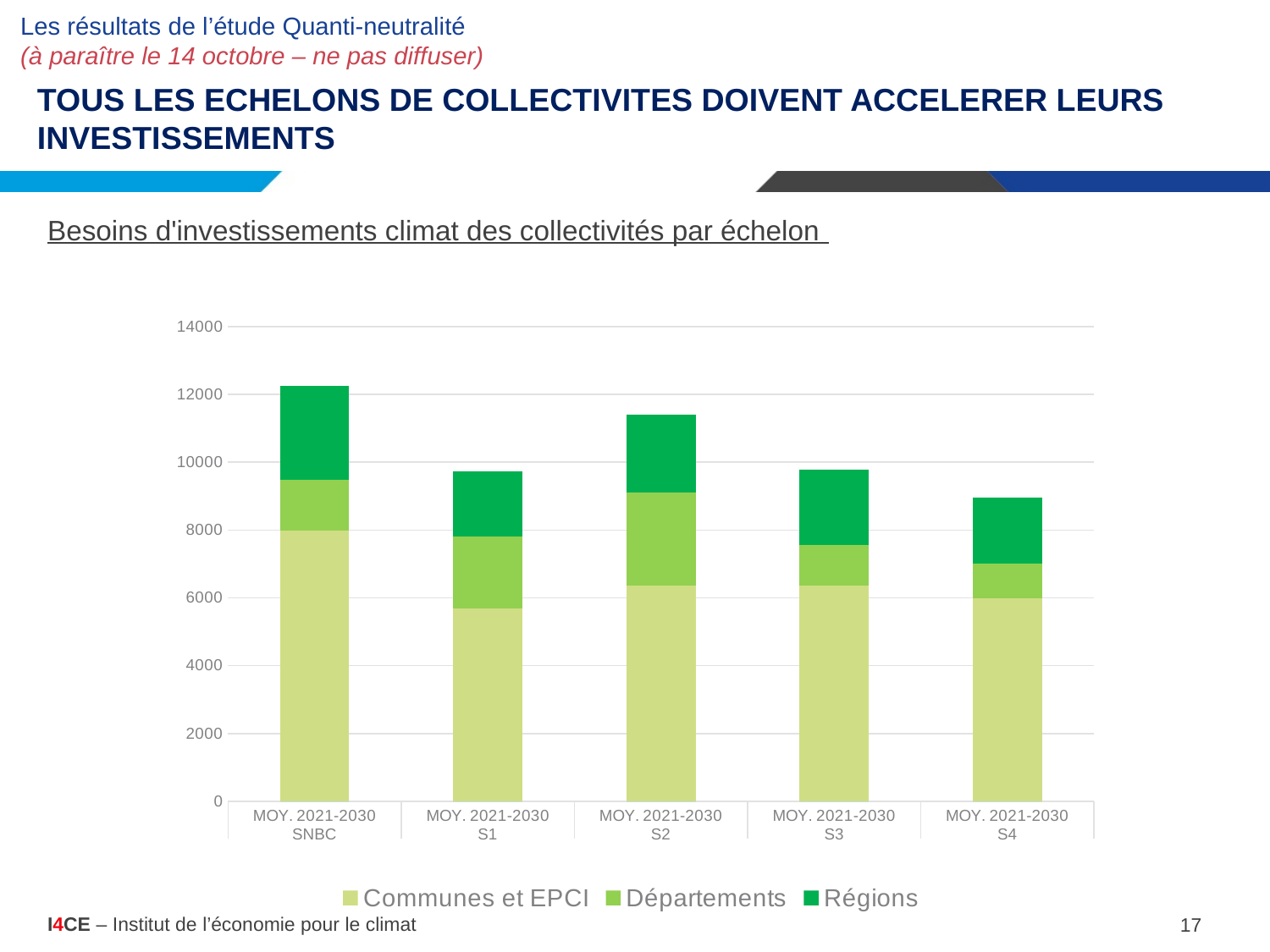
Which series is shown in the darkest green at the top of each stacked bar? Régions How many categories are shown on the x axis of the chart? 5 Is the Communes et EPCI value for MOY. 2021-2030 S1 greater or less than 6000? less How many series does the chart legend list? 3 Is the total stacked value for MOY. 2021-2030 S4 greater or less than 10000? less What is the title of the chart? Besoins d'investissements climat des collectivités par échelon Which category has the highest total stacked bar? MOY. 2021-2030 SNBC Is the total stacked value for MOY. 2021-2030 SNBC greater or less than 12000? greater What kind of chart is shown on the slide? Stacked bar chart Which has the larger total stacked bar, MOY. 2021-2030 SNBC or MOY. 2021-2030 S1? MOY. 2021-2030 SNBC Which category has the lowest total stacked bar? MOY. 2021-2030 S4